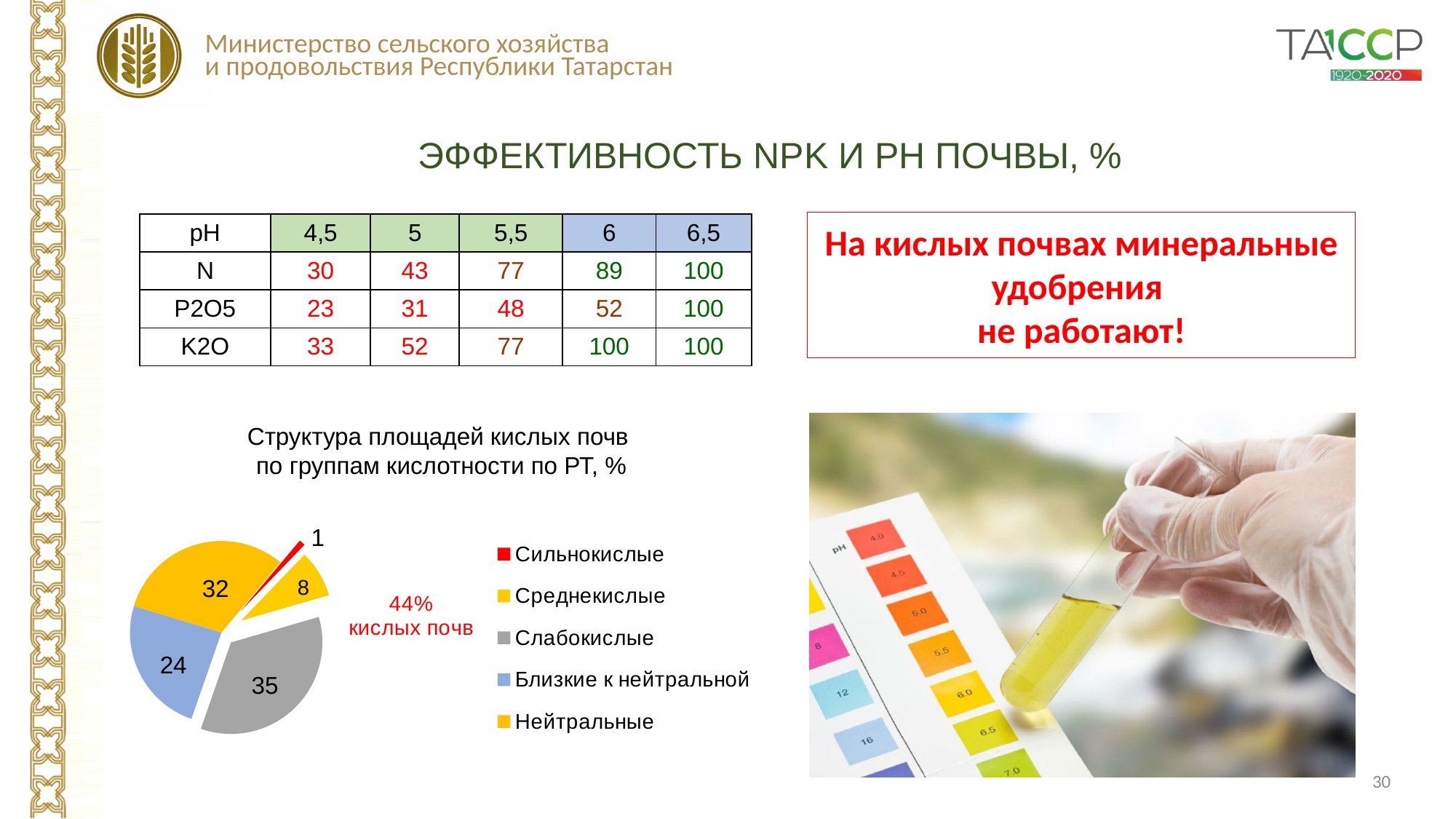
Which category has the smallest slice in the pie chart? Сильнокислые What percentage of acidic soils is noted in red text next to the pie chart? 44% In the pie chart, what is the difference between the values for Слабокислые and Близкие к нейтральной? 11 How many entries does the legend of the pie chart list? 5 What kind of chart is shown under the title "Структура площадей кислых почв по группам кислотности по РТ, %"? pie chart In the pie chart, what is the value for Слабокислые? 35 Which category has the largest slice in the pie chart? Слабокислые In the pie chart, what is the value for Нейтральные? 32 In the pie chart, what is the value for Сильнокислые? 1 In the pie chart, what is the value for Среднекислые? 8 In the pie chart, what is the value for Близкие к нейтральной? 24 In the pie chart, which is larger: Нейтральные or Близкие к нейтральной? Нейтральные